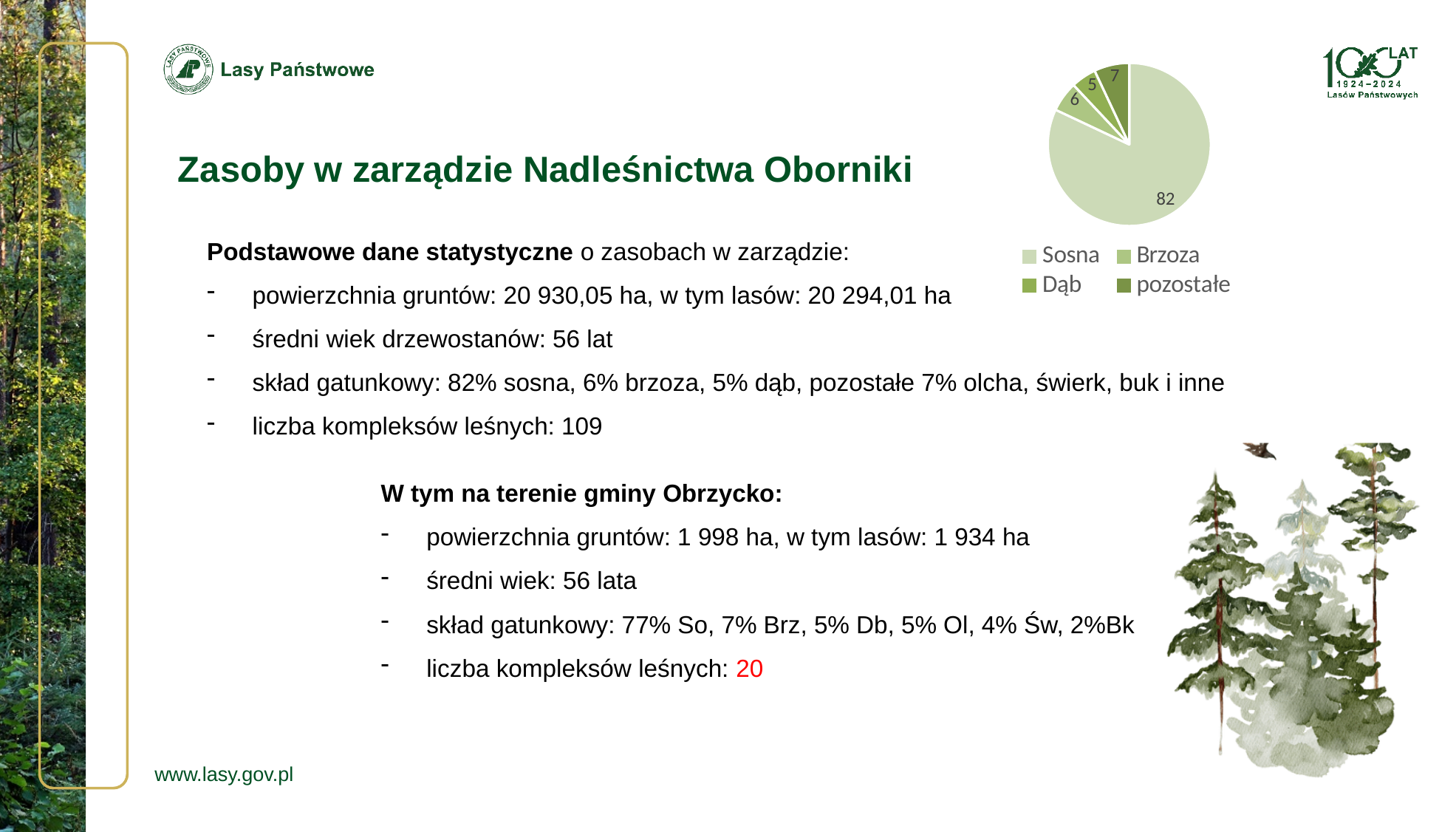
Which category has the smallest slice in the pie chart? Dąb How many entries does the pie chart legend list? 4 What is the difference between the values for Sosna and pozostałe in the pie chart? 75 Which category has the largest slice in the pie chart? Sosna What is the total of all the values shown in the pie chart? 100 What value is shown for Brzoza in the pie chart? 6 Which is larger in the pie chart, Brzoza or pozostałe? pozostałe What kind of chart is shown on the slide? pie chart What value is shown for pozostałe in the pie chart? 7 What value is shown for Sosna in the pie chart? 82 How many slices does the pie chart have? 4 What value is shown for Dąb in the pie chart? 5